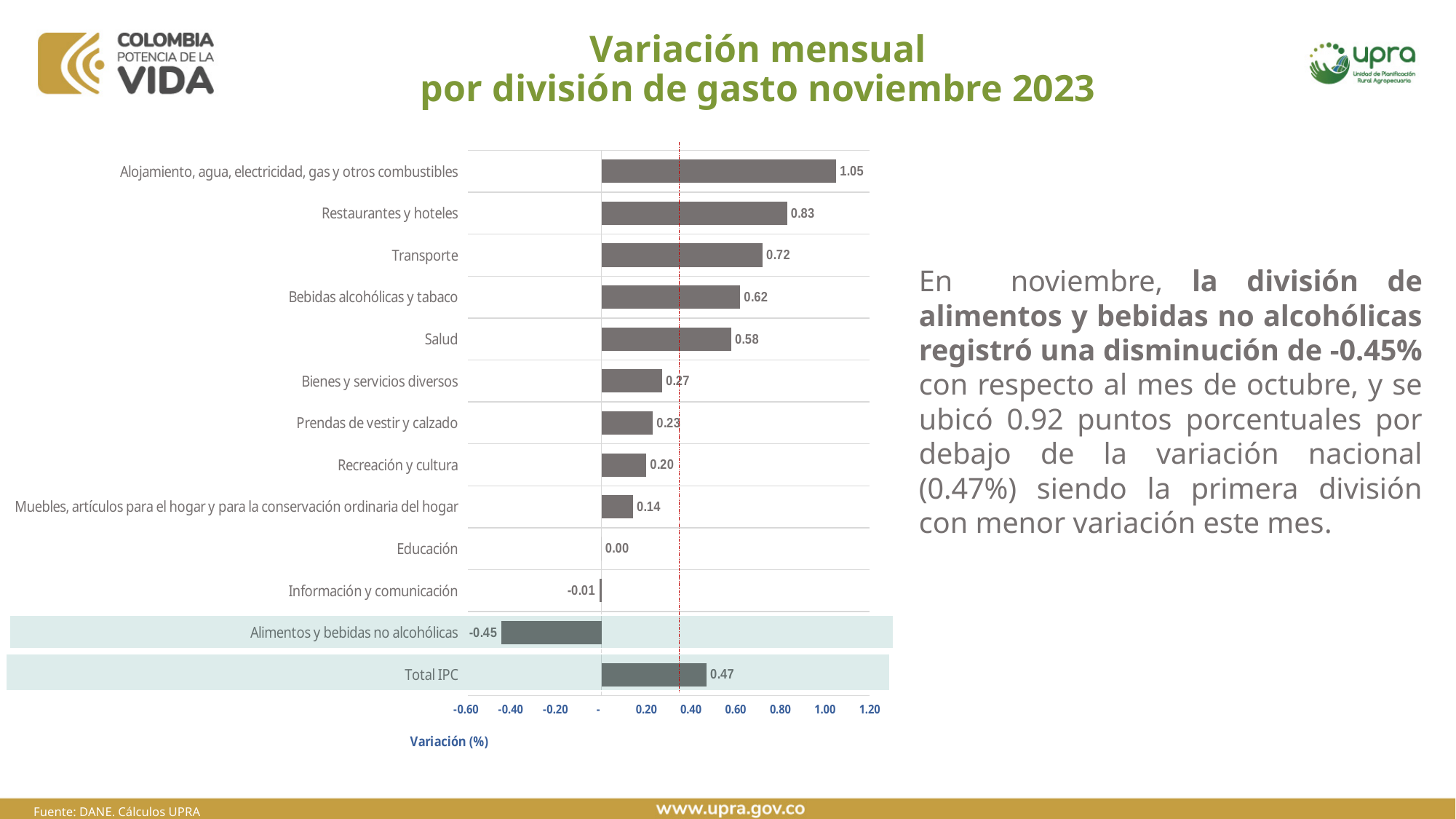
What is the value for Transporte? 0.72 How many categories are shown in the chart? 13 What is the value for Total IPC? 0.47 Which category has the highest value? Alojamiento, agua, electricidad, gas y otros combustibles What kind of chart is shown on the slide? Bar chart Which is larger, the value for Bebidas alcohólicas y tabaco or the value for Bienes y servicios diversos? Bebidas alcohólicas y tabaco What is the value for Educación? 0.00 Which category has the lowest value? Alimentos y bebidas no alcohólicas What is the value for Muebles, artículos para el hogar y para la conservación ordinaria del hogar? 0.14 What is the difference between the values for Restaurantes y hoteles and Salud? 0.25 What is the value for Alimentos y bebidas no alcohólicas? -0.45 What is the label of the x axis? Variación (%)